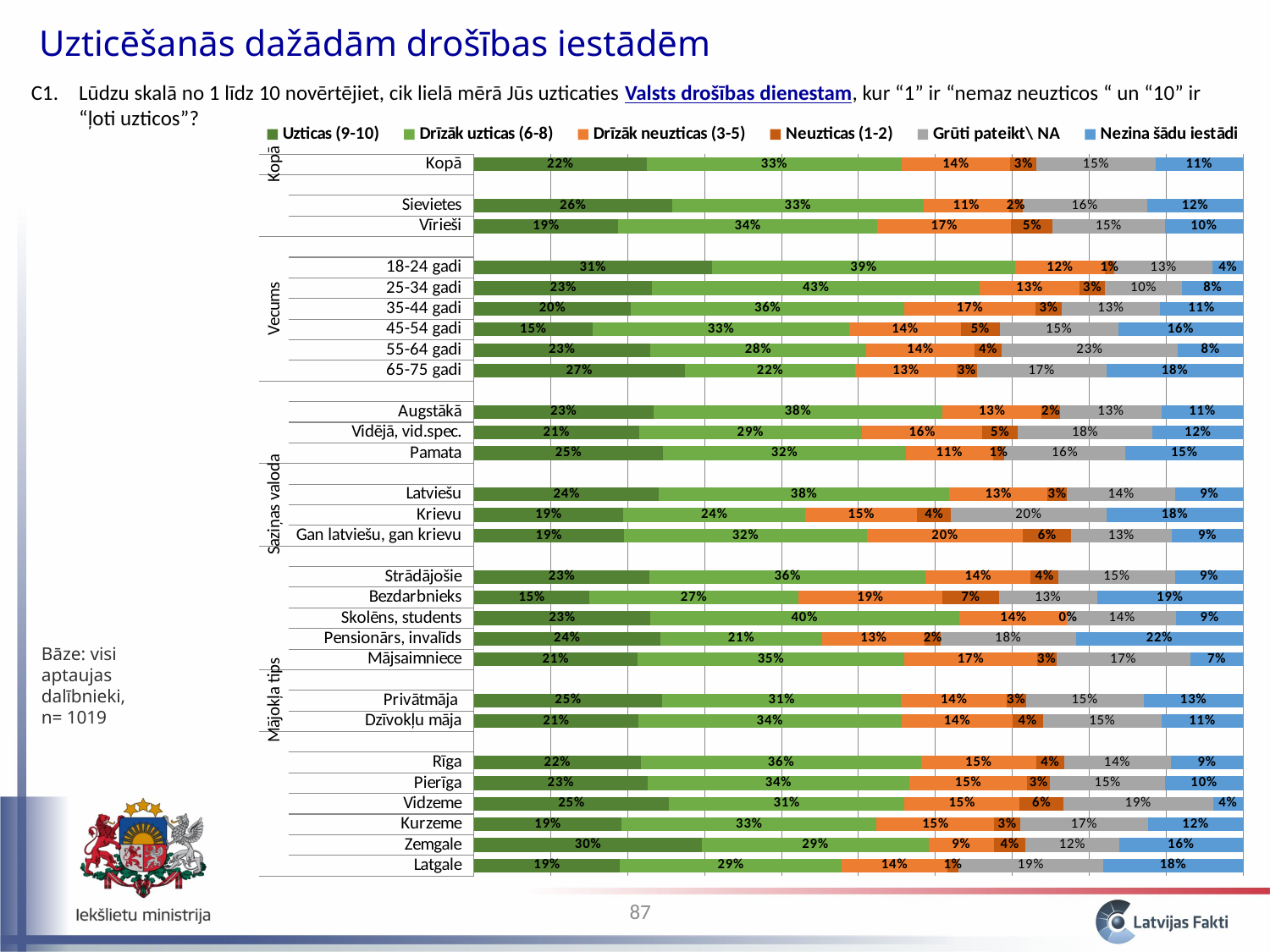
What kind of chart is shown on the slide? Stacked bar chart What is the value of Drīzāk uzticas (6-8) for 25-34 gadi? 43% Among the age groups (Vecums), which has the highest Uzticas (9-10) value? 18-24 gadi What is the value of Uzticas (9-10) for Kopā? 22% What is the difference in Uzticas (9-10) between Sievietes and Vīrieši? 7 percentage points How many series does the legend list? 6 Among the age groups (Vecums), which has the lowest Uzticas (9-10) value? 45-54 gadi Which has a larger Drīzāk uzticas (6-8) value, Latviešu or Krievu? Latviešu What is the value of Nezina šādu iestādi for Pensionārs, invalīds? 22% What is the value of Grūti pateikt\ NA for Krievu? 20% What is the value of Neuzticas (1-2) for Bezdarbnieks? 7% What is the total of the stacked bar for Rīga? 100%